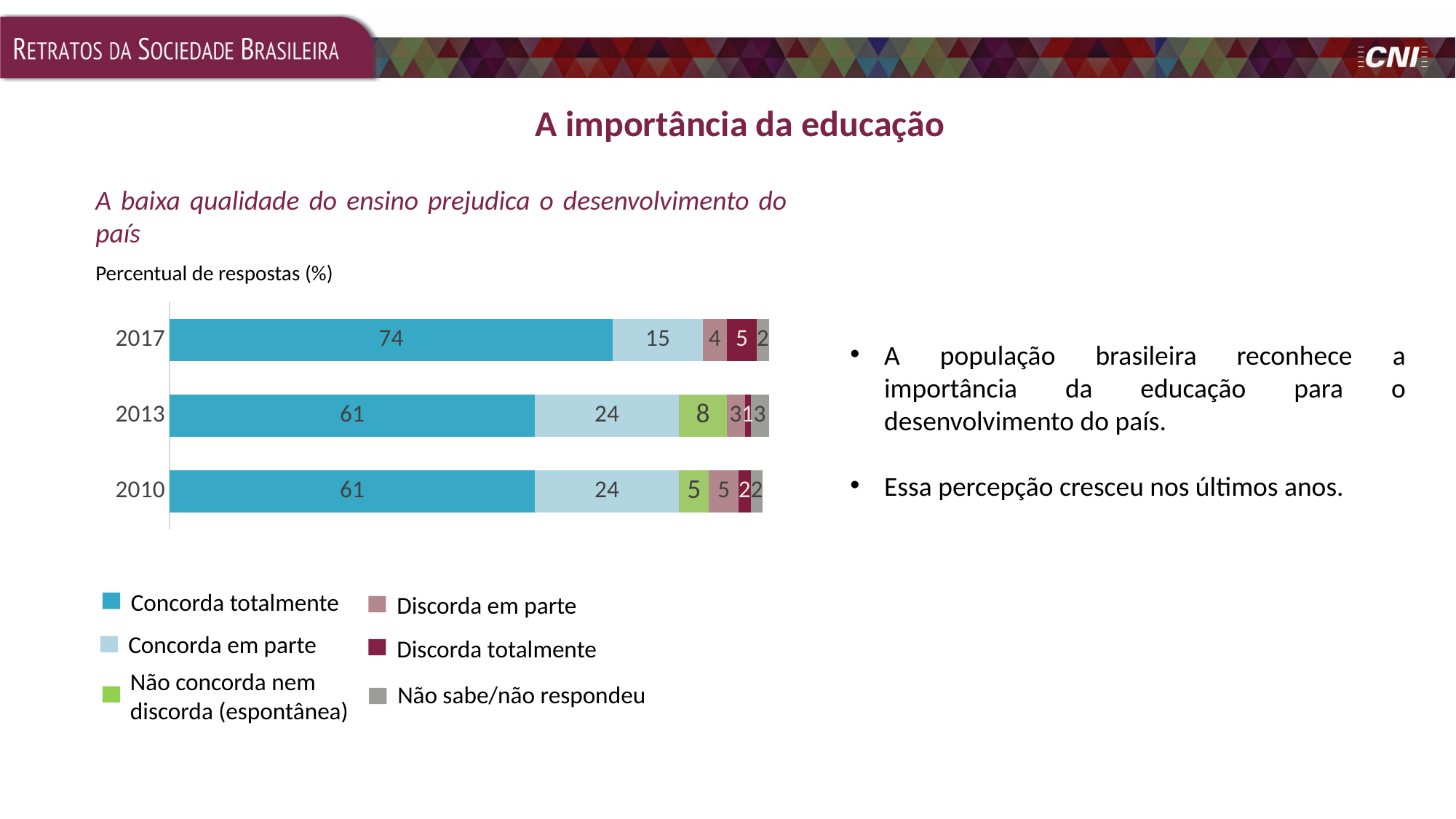
How many years are shown in the chart? 3 How many series does the legend list? 6 What percentage of respondents answered "Concorda em parte" in 2013? 24 What is the total of the stacked bar for 2010? 99 What is the value for "Discorda totalmente" in 2017? 5 What percentage of respondents answered "Concorda totalmente" in 2017? 74 By how much did the "Concorda totalmente" value increase from 2013 to 2017? 13 Which year has the highest value for "Concorda totalmente"? 2017 Which is larger: "Discorda em parte" in 2010 or "Discorda em parte" in 2013? 2010 What is the value for "Não concorda nem discorda (espontânea)" in 2013? 8 Which year has the lowest value for "Concorda em parte"? 2017 What kind of chart is shown on the slide? Stacked bar chart